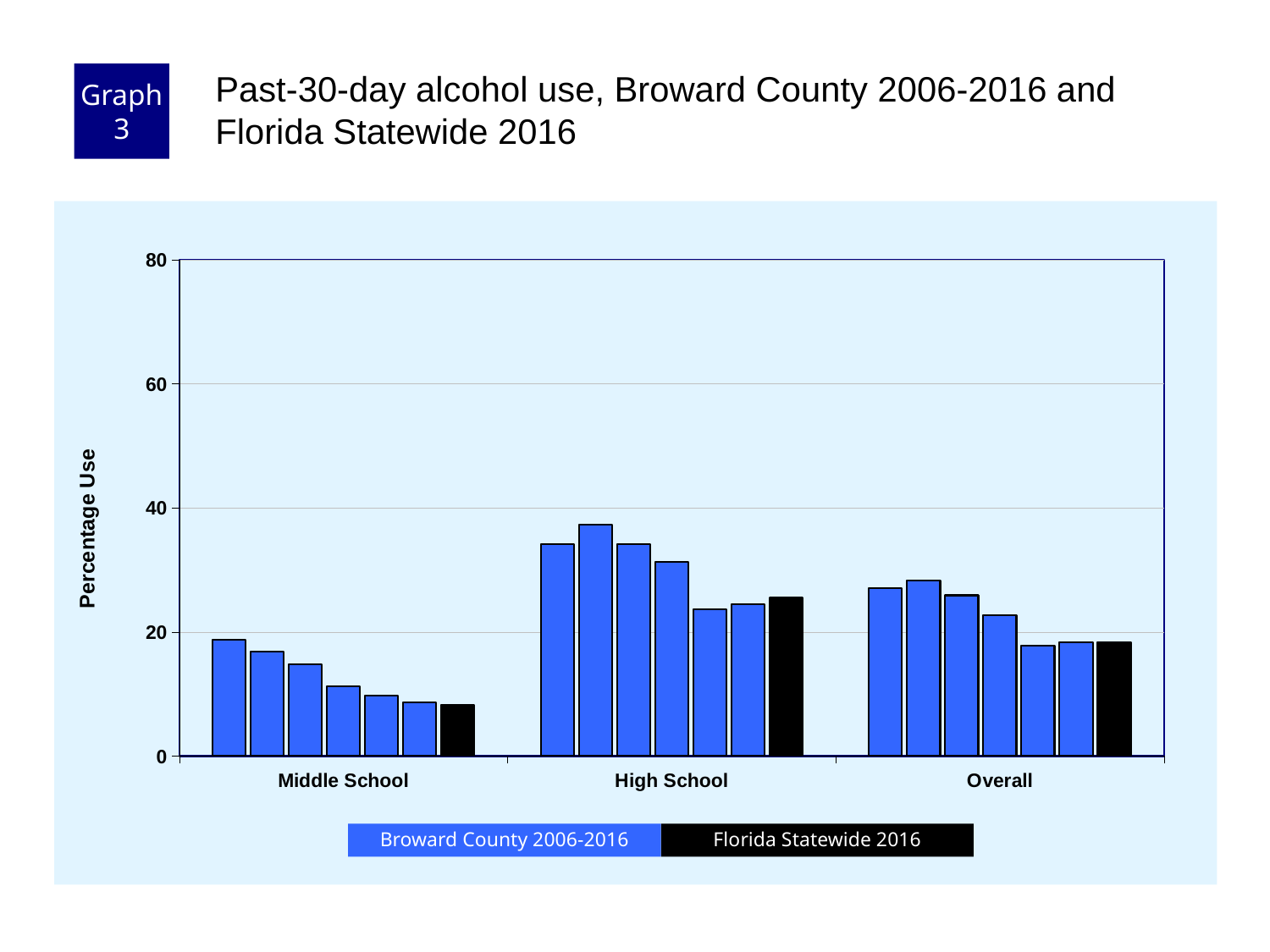
Which category has the lowest bars? Middle School Is the tallest Broward County bar for High School greater or less than 40? less What kind of chart is shown on the slide? bar chart Is the Florida Statewide 2016 value for Middle School greater or less than 20? less Which category has the highest bars? High School Is the first Broward County bar for Overall greater or less than 20? greater Do the Broward County bars for Middle School rise or fall from left to right? fall Which is larger, the Florida Statewide 2016 value for High School or for Middle School? High School How many categories are shown on the x axis? 3 How many series does the legend list? 2 What is the label on the y axis? Percentage Use